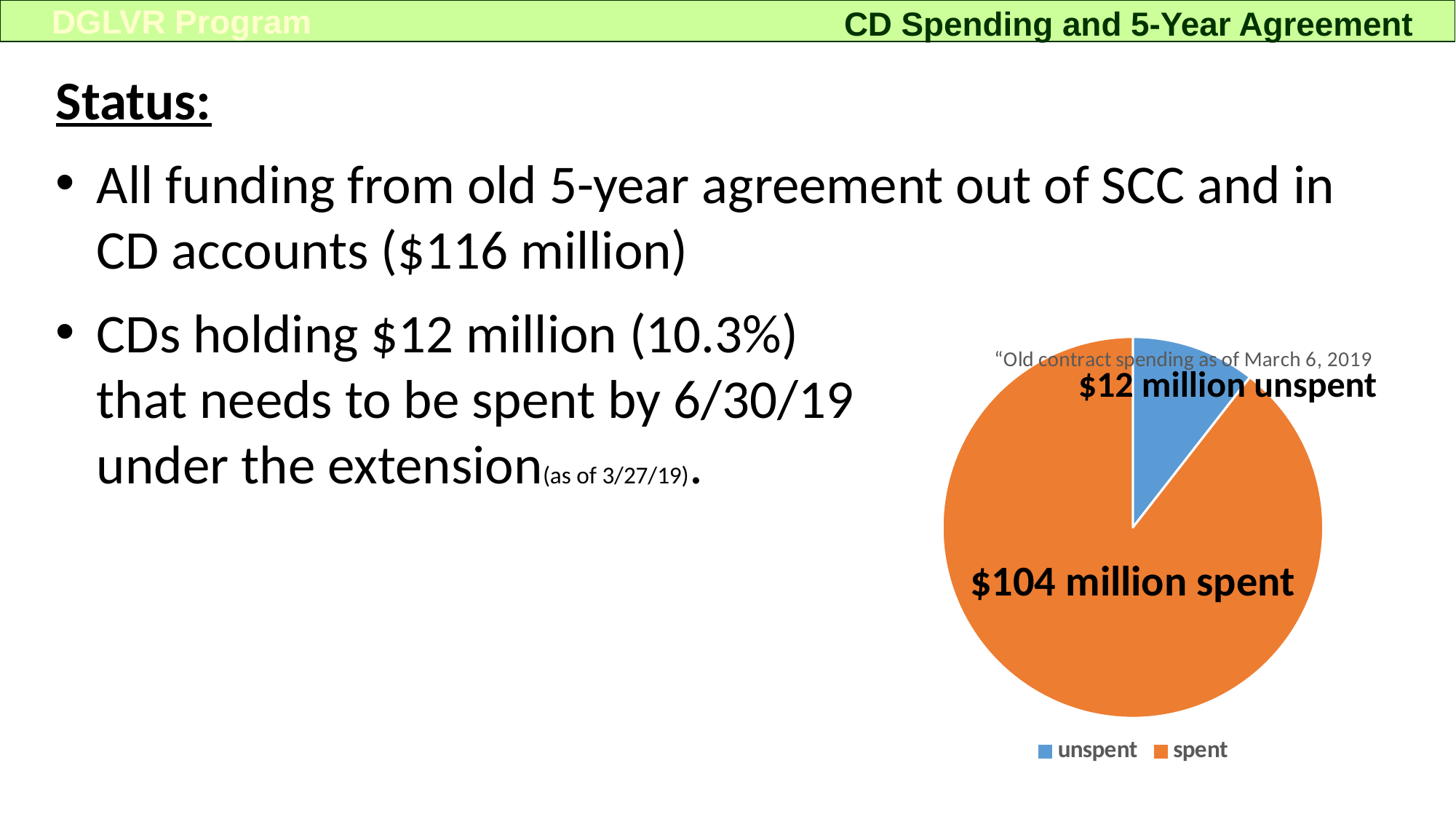
Which slice of the pie chart is the largest? spent How many entries does the pie chart's legend list? 2 What amount does the pie chart show as unspent? $12 million What is the total of the spent and unspent amounts shown in the pie chart? $116 million What colour is the spent slice in the pie chart? orange What is the difference between the spent and unspent amounts in the pie chart? $92 million What kind of chart is shown on the slide? pie chart What is the title of the pie chart? Old contract spending as of March 6, 2019 Which slice of the pie chart is the smallest? unspent Which is larger in the pie chart, the spent amount or the unspent amount? spent How many slices does the pie chart have? 2 What amount does the pie chart show as spent? $104 million